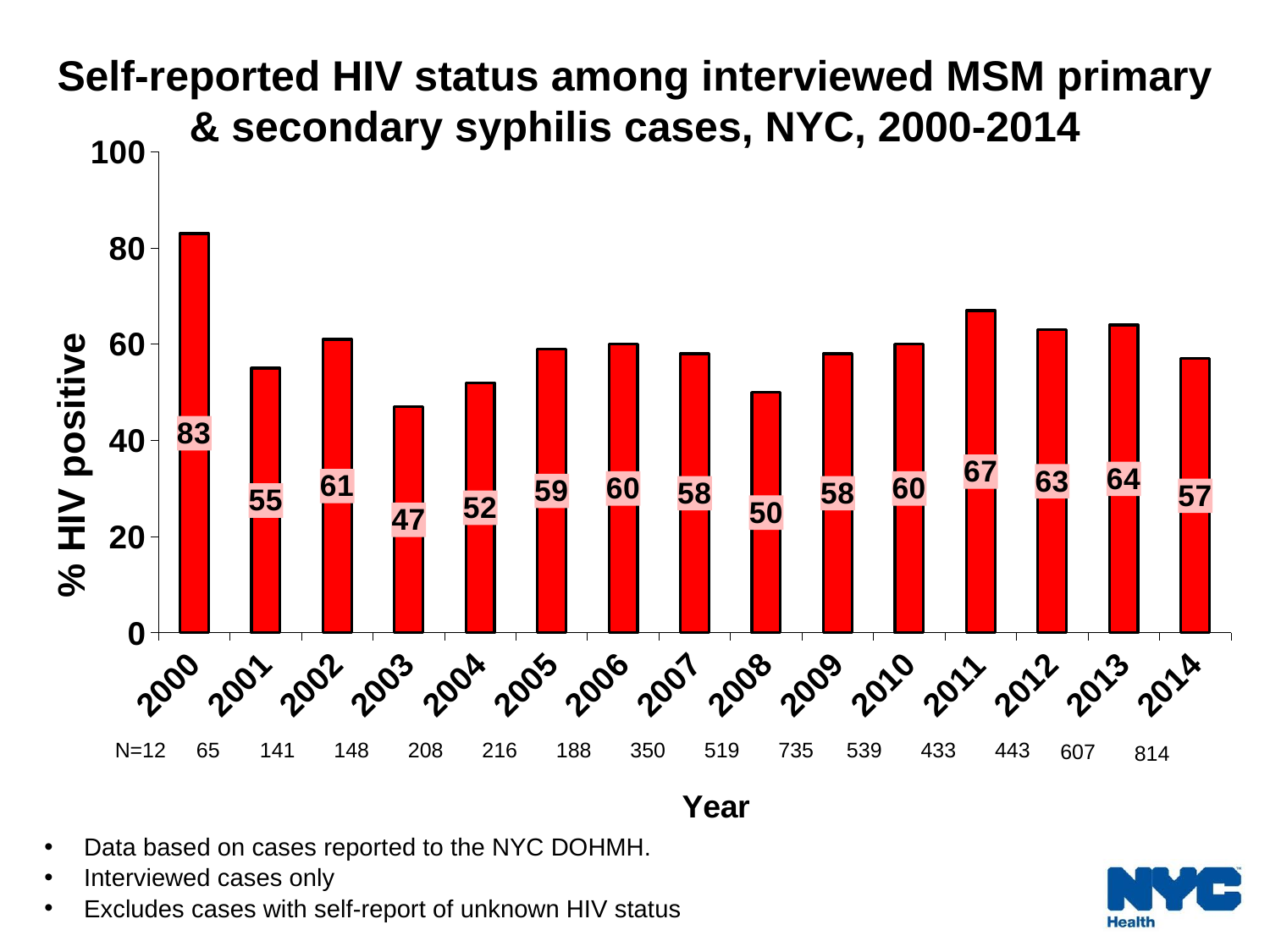
Which year has a higher % HIV positive, 2002 or 2008? 2002 What is the % HIV positive value for 2011? 67 Is the value for 2004 greater or less than 60? less What is the % HIV positive value for 2014? 57 How many years are shown on the x axis? 15 What is the difference in % HIV positive between 2000 and 2003? 36 What kind of chart is shown on the slide? Bar chart What is the difference in % HIV positive between 2011 and 2014? 10 What is the label of the y axis? % HIV positive Which year has the highest % HIV positive? 2000 Which year has the lowest % HIV positive? 2003 What is the % HIV positive value for 2000? 83